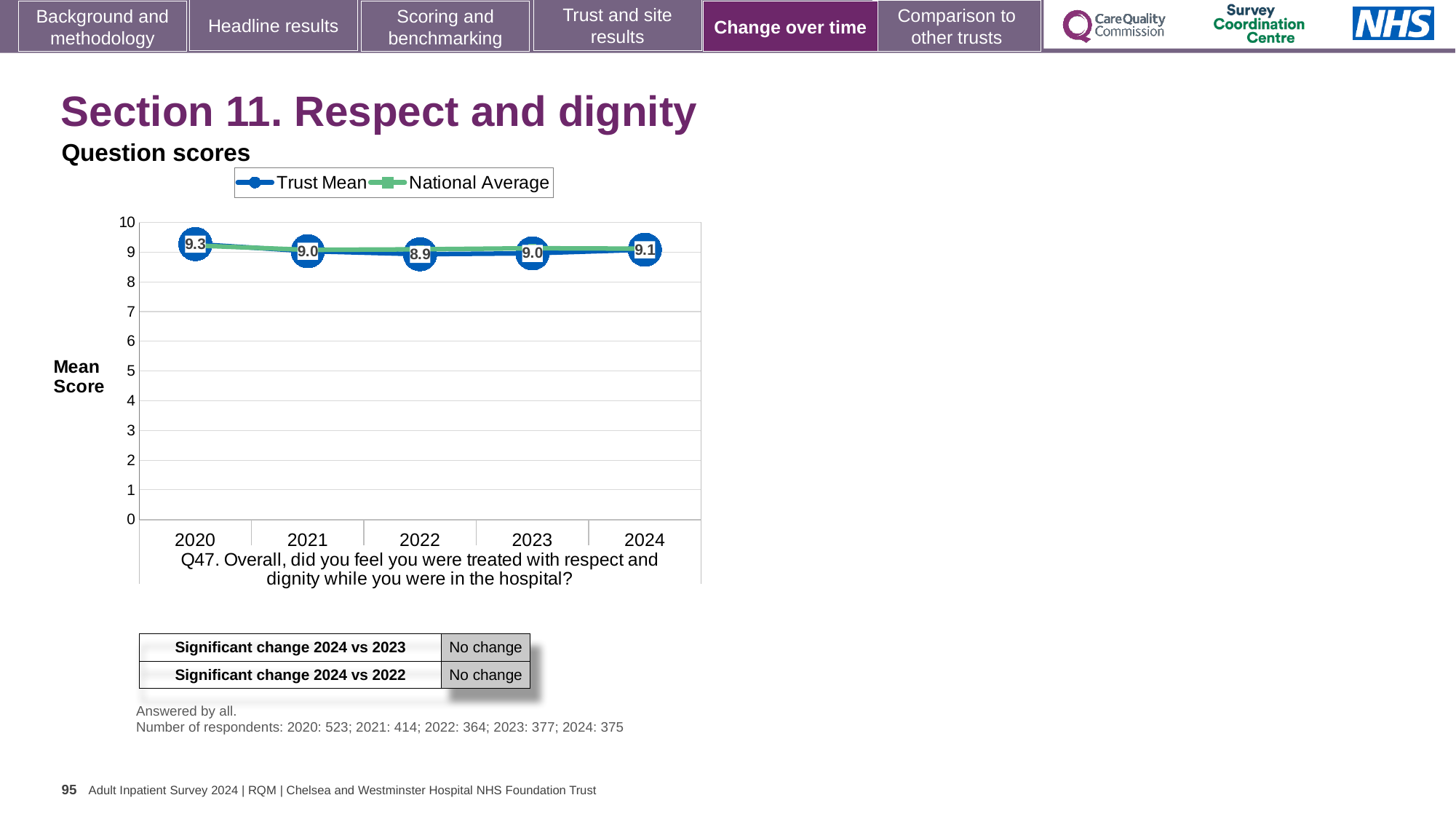
Which is larger, the Trust Mean score in 2020 or in 2024? 2020 What is the Trust Mean score for 2024? 9.1 How many years are plotted on the x axis? 5 How many series does the legend list? 2 What is the Trust Mean score for 2020? 9.3 In which year is the Trust Mean score highest? 2020 What kind of chart is shown on the slide? Line chart What is the Trust Mean score for 2022? 8.9 What is the difference between the Trust Mean score in 2020 and in 2022? 0.4 Is the National Average value for 2024 greater or less than 8? greater In which year is the Trust Mean score lowest? 2022 What is the label on the y axis of the chart? Mean Score